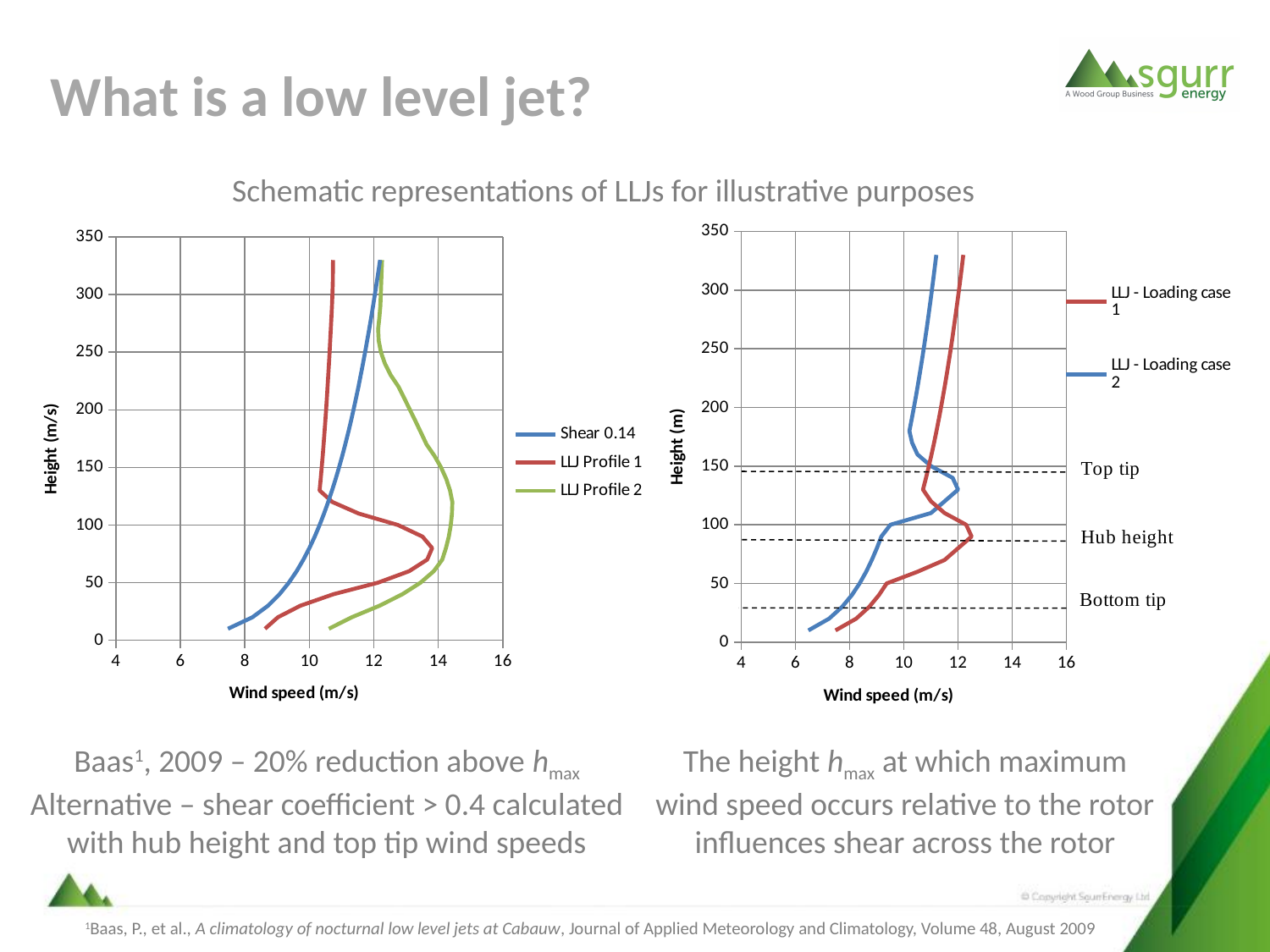
What is the x-axis title of the left chart? Wind speed (m/s) In the right chart, at a height of 330 m, which series has the higher wind speed, LLJ - Loading case 1 or LLJ - Loading case 2? LLJ - Loading case 1 What kind of chart is the left chart on the slide? line chart In the left chart, which series reaches the highest wind speed? LLJ Profile 2 How many series does the legend of the right chart list? 2 How many series does the legend of the left chart list? 3 In the left chart, is the wind speed of the Shear 0.14 series at a height of 10 m greater or less than 8 m/s? less In the right chart, is the dashed Hub height line above or below 100 m? below In the left chart, is the wind speed of LLJ Profile 2 at a height of 10 m greater or less than 10 m/s? greater What are the three dashed reference lines in the right chart labelled? Top tip, Hub height, Bottom tip